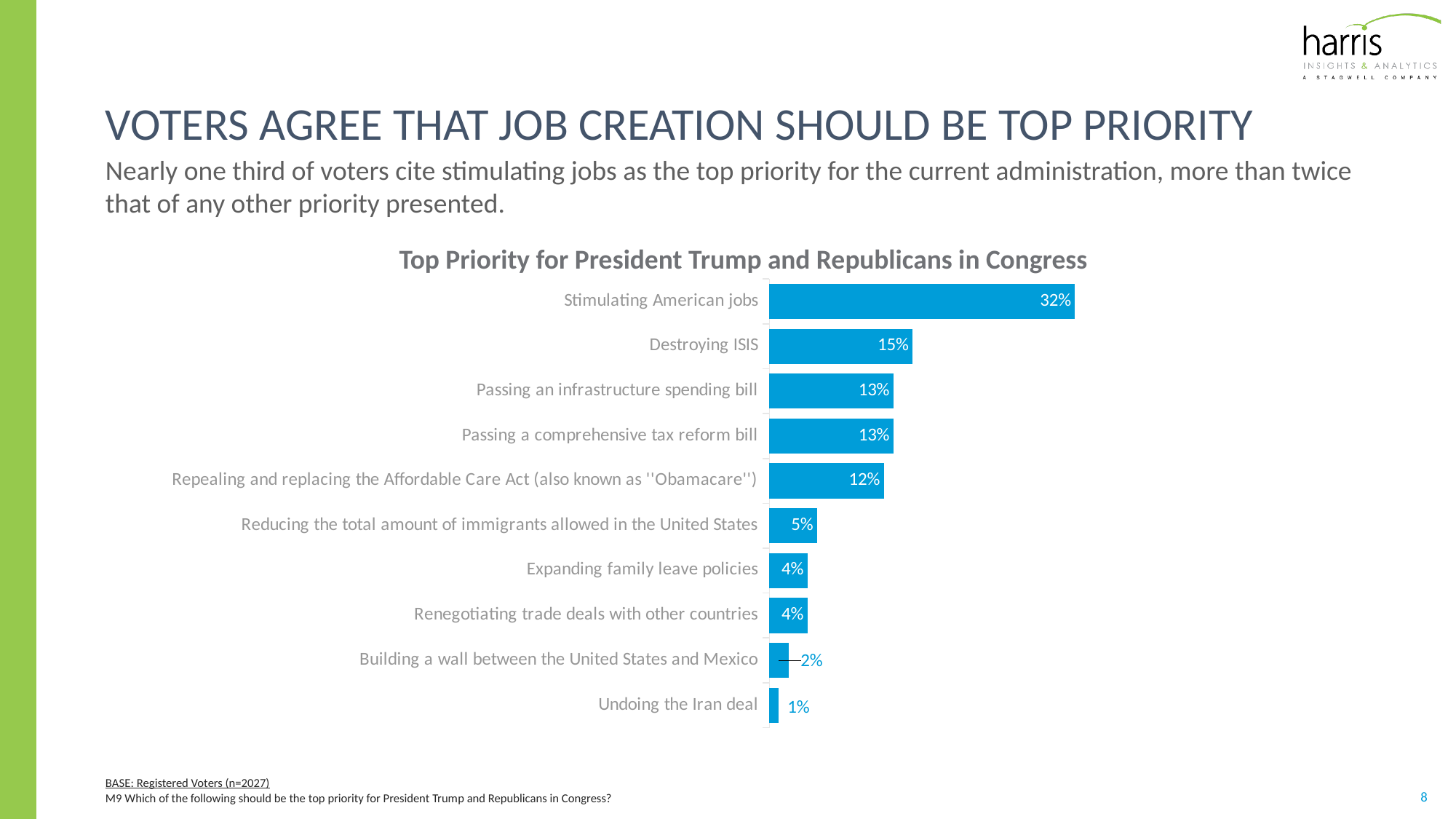
What is the difference in percentage points between Stimulating American jobs and Destroying ISIS? 17 Which priority has the lowest percentage? Undoing the Iran deal What is the value shown for Destroying ISIS? 15% What percentage is shown for Repealing and replacing the Affordable Care Act? 12% What percentage of voters chose Stimulating American jobs as the top priority? 32% Which has a higher value: Reducing the total amount of immigrants allowed in the United States or Expanding family leave policies? Reducing the total amount of immigrants allowed in the United States Which priority has the highest percentage? Stimulating American jobs What is the difference in percentage points between Passing an infrastructure spending bill and Renegotiating trade deals with other countries? 9 What is the title of the chart? Top Priority for President Trump and Republicans in Congress How many priorities are shown in the chart? 10 What type of chart is shown on the slide? Bar chart What is the value for Building a wall between the United States and Mexico? 2%